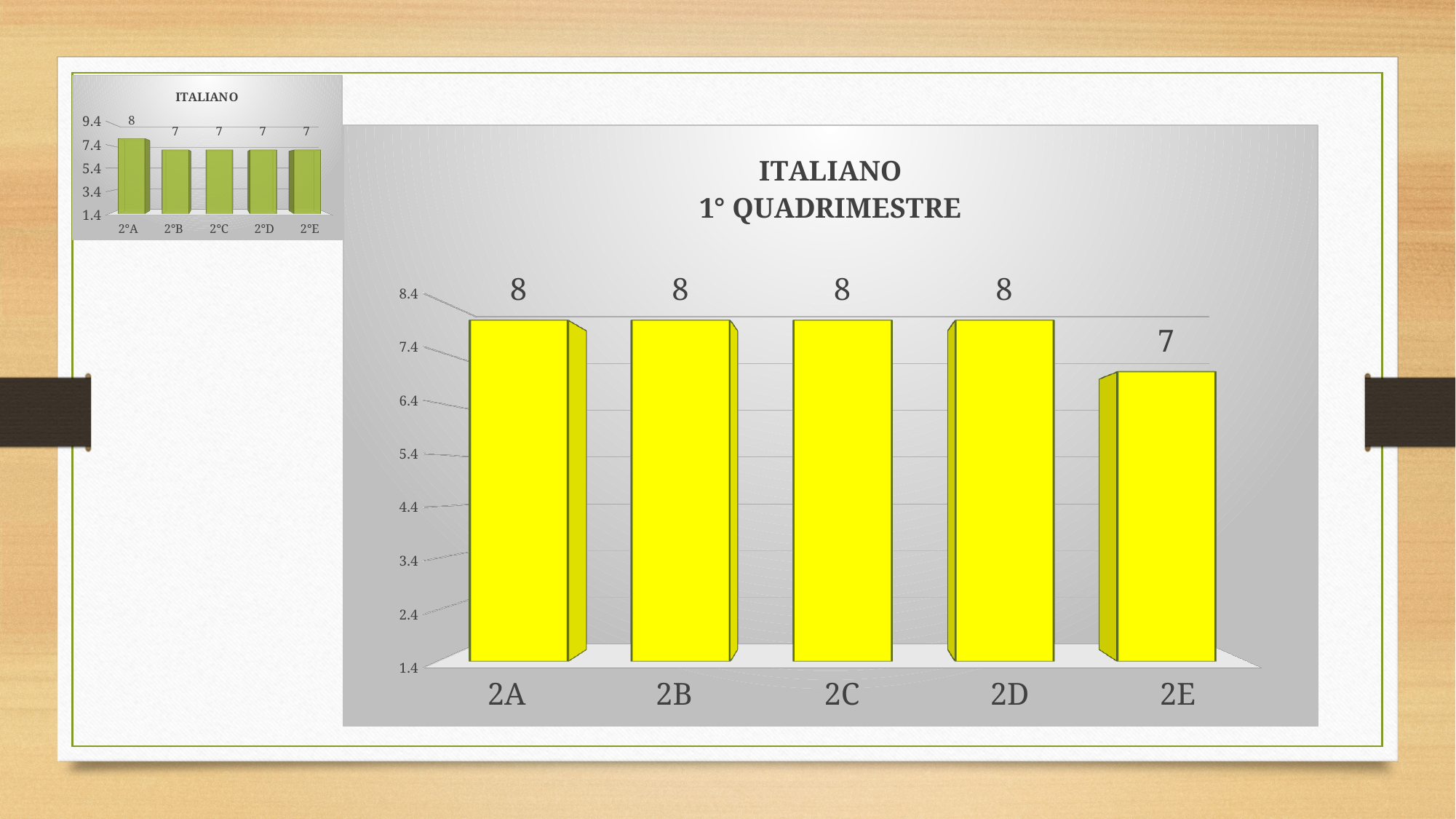
In the small chart at the top left titled 'ITALIANO', which category has the highest value? 2°A In the large chart titled 'ITALIANO 1° QUADRIMESTRE', what is the difference between the values for 2D and 2E? 1 In the small chart at the top left titled 'ITALIANO', what is the difference between the values for 2°A and 2°B? 1 In the large chart titled 'ITALIANO 1° QUADRIMESTRE', what is the value for 2A? 8 In the small chart at the top left titled 'ITALIANO', what is the value for 2°C? 7 In the large chart titled 'ITALIANO 1° QUADRIMESTRE', which is larger, the value for 2C or the value for 2E? 2C What kind of chart is the large chart titled 'ITALIANO 1° QUADRIMESTRE'? bar chart In the small chart at the top left titled 'ITALIANO', what is the value for 2°A? 8 In the large chart titled 'ITALIANO 1° QUADRIMESTRE', what colour are the bars? yellow In the large chart titled 'ITALIANO 1° QUADRIMESTRE', what is the value for 2E? 7 In the large chart titled 'ITALIANO 1° QUADRIMESTRE', which category has the lowest value? 2E In the large chart titled 'ITALIANO 1° QUADRIMESTRE', how many categories are shown on the x axis? 5